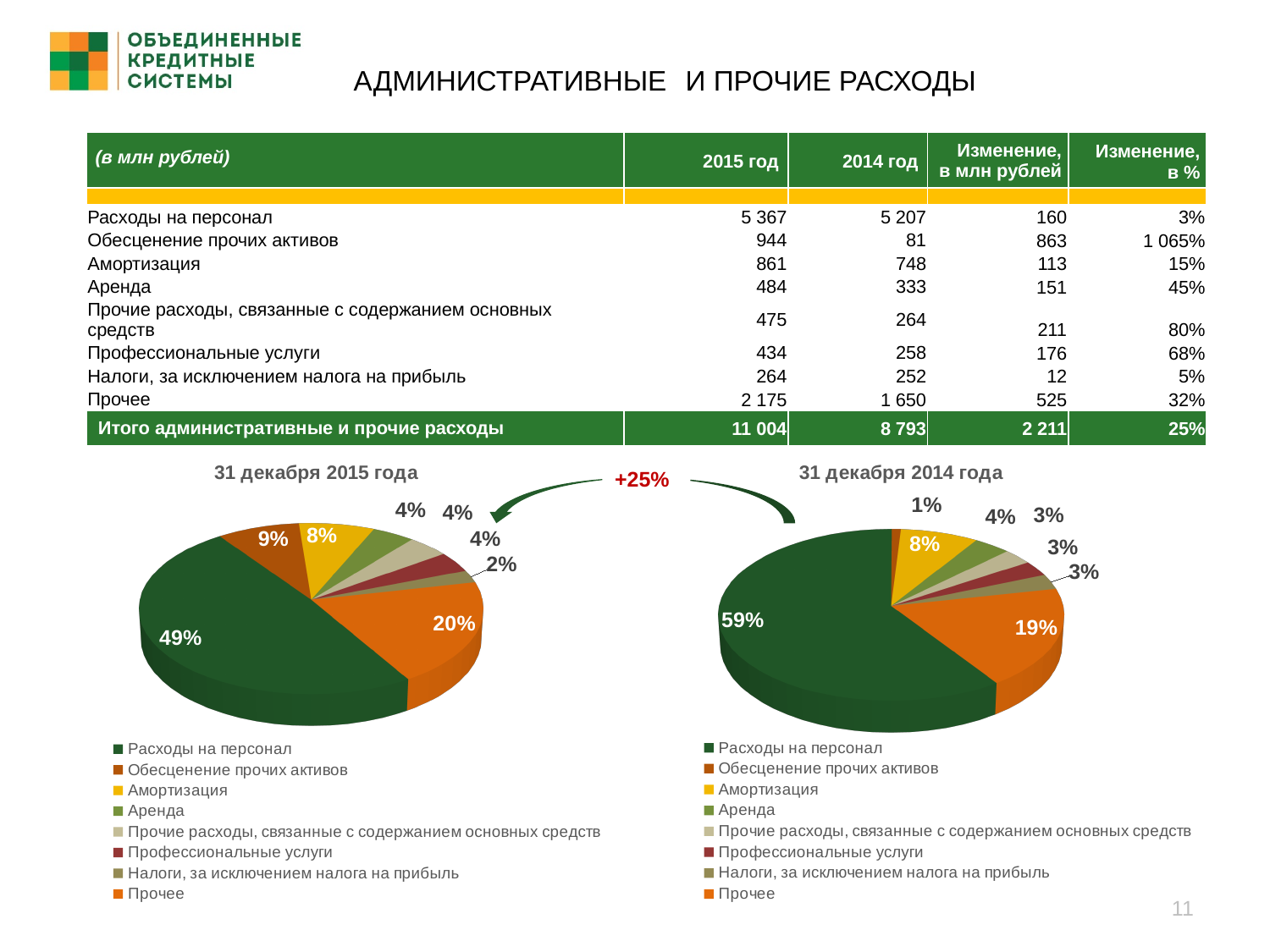
In the pie chart titled "31 декабря 2015 года", which is larger: the slice for "Прочее" or the slice for "Амортизация"? Прочее In the pie chart titled "31 декабря 2014 года", what share does "Расходы на персонал" have? 59% What percentage change is shown on the arrow between the two pie charts? +25% In the pie chart titled "31 декабря 2014 года", what share does "Амортизация" have? 8% In the pie chart titled "31 декабря 2014 года", what share does "Прочее" have? 19% In the pie chart titled "31 декабря 2015 года", which category has the largest slice? Расходы на персонал In the pie chart titled "31 декабря 2014 года", which category has the smallest slice? Обесценение прочих активов How many categories does the legend of the pie chart titled "31 декабря 2015 года" list? 8 What kind of chart is the chart titled "31 декабря 2014 года"? Pie chart